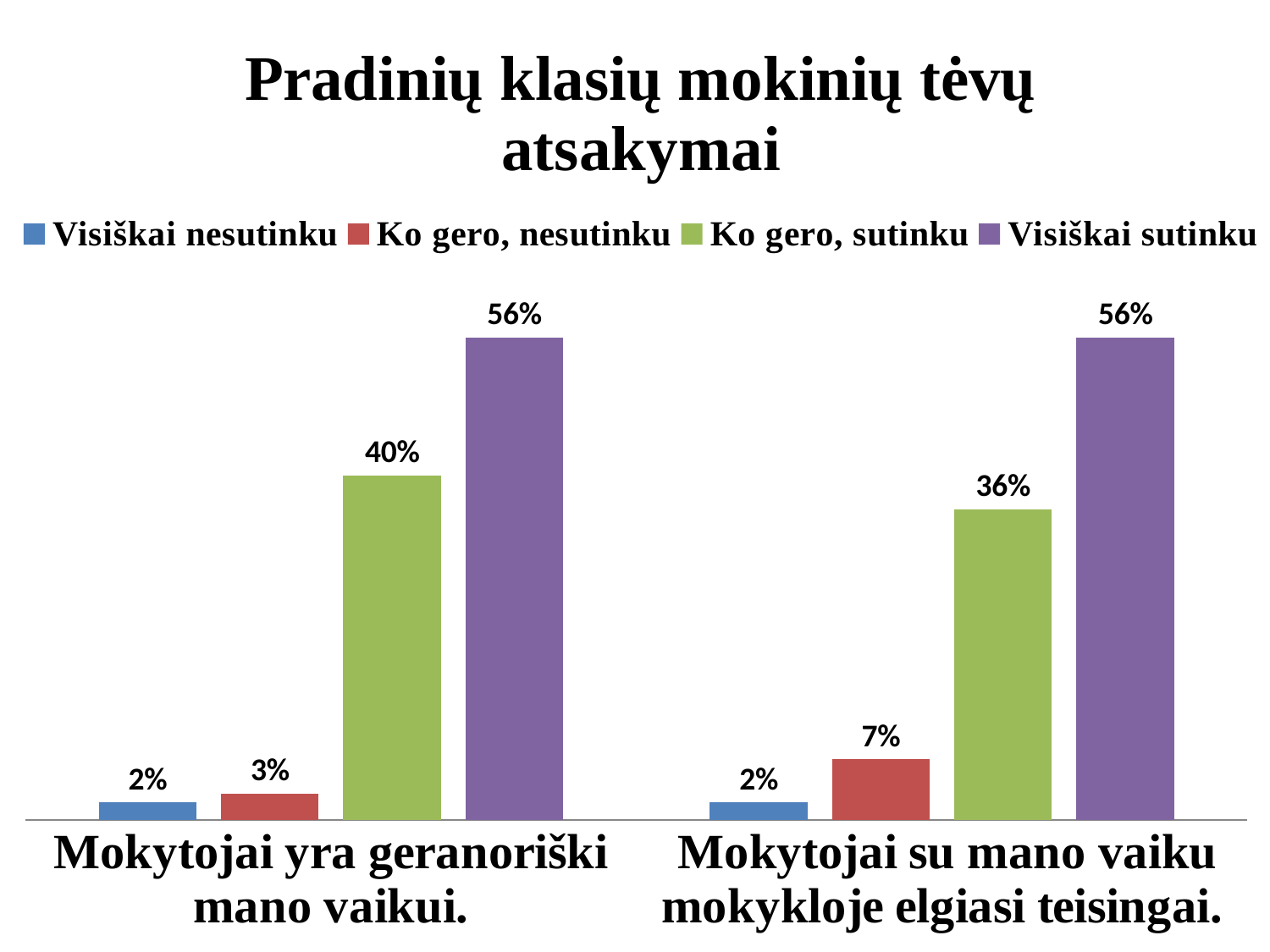
What is the value for "Visiškai nesutinku" in the category "Mokytojai yra geranoriški mano vaikui."? 2% What is the difference between the "Ko gero, sutinku" values for the two categories? 4% What kind of chart is shown on the slide? Bar chart What is the value for "Visiškai sutinku" in the category "Mokytojai su mano vaiku mokykloje elgiasi teisingai."? 56% How many series does the legend list? 4 What is the value for "Ko gero, nesutinku" in the category "Mokytojai su mano vaiku mokykloje elgiasi teisingai."? 7% Which series has the lowest value in the category "Mokytojai su mano vaiku mokykloje elgiasi teisingai."? Visiškai nesutinku Which is larger: "Ko gero, nesutinku" for "Mokytojai yra geranoriški mano vaikui." or for "Mokytojai su mano vaiku mokykloje elgiasi teisingai."? Mokytojai su mano vaiku mokykloje elgiasi teisingai. Which series has the highest value in the category "Mokytojai yra geranoriški mano vaikui."? Visiškai sutinku What is the value for "Ko gero, sutinku" in the category "Mokytojai yra geranoriški mano vaikui."? 40% How many categories are shown on the x axis? 2 What is the difference between "Visiškai sutinku" and "Ko gero, sutinku" in the category "Mokytojai yra geranoriški mano vaikui."? 16%